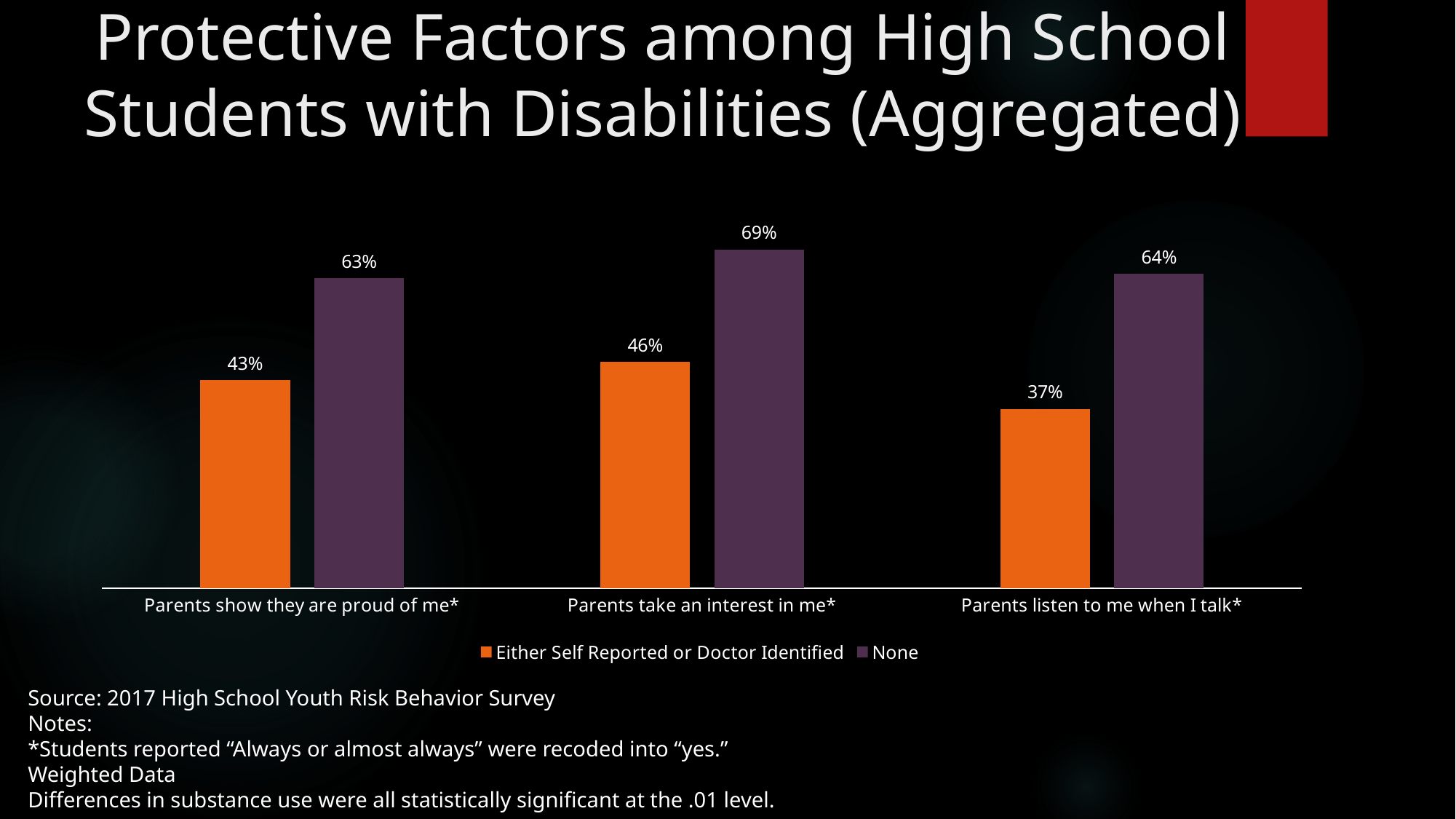
What is the value for "Either Self Reported or Doctor Identified" for "Parents listen to me when I talk*"? 37% For "Parents show they are proud of me*", which series has the larger value? None What is the value for "None" for "Parents take an interest in me*"? 69% What is the difference between the "None" and "Either Self Reported or Doctor Identified" values for "Parents listen to me when I talk*"? 27% Which category has the lowest value for the "Either Self Reported or Doctor Identified" series? Parents listen to me when I talk* How many categories are shown on the x axis? 3 Which category has the highest value for the "None" series? Parents take an interest in me* What is the value for "None" for "Parents listen to me when I talk*"? 64% What is the value for "Either Self Reported or Doctor Identified" for "Parents show they are proud of me*"? 43% What is the difference between the "None" and "Either Self Reported or Doctor Identified" values for "Parents take an interest in me*"? 23% How many series does the legend list? 2 What kind of chart is shown on the slide? Bar chart